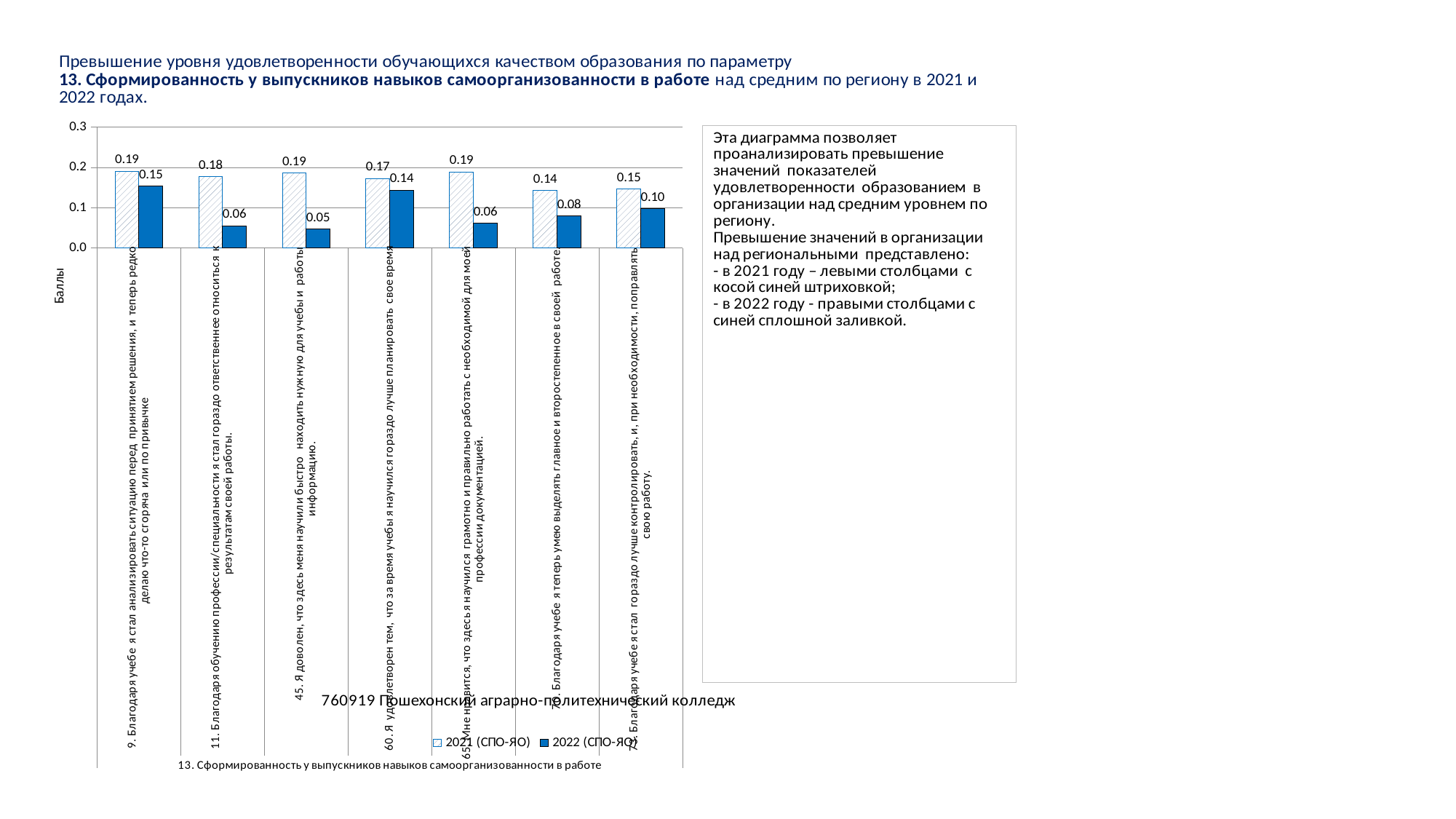
How many categories (statements) are plotted on the x axis? 7 What is the 2022 (СПО-ЯО) value for the last statement on the x axis ("Благодаря учебе я стал гораздо лучше контролировать и, при необходимости, поправлять свою работу")? 0.10 Which statement has the lowest 2022 (СПО-ЯО) value? 45. Я доволен, что здесь меня научили быстро находить нужную для учебы и работы информацию What type of chart is shown on the slide? bar chart What is the 2022 (СПО-ЯО) value for statement 45 ("Я доволен, что здесь меня научили быстро находить нужную для учебы и работы информацию")? 0.05 What is the 2022 (СПО-ЯО) value for statement 60 ("Я удовлетворен тем, что за время учебы я научился гораздо лучше планировать свое время")? 0.14 For statement 65 ("Мне нравится, что здесь я научился грамотно и правильно работать с необходимой для моей профессии документацией"), which series has the larger value, 2021 or 2022? 2021 (СПО-ЯО) What is the label of the vertical axis? Баллы Which statement has the highest 2022 (СПО-ЯО) value? 9. Благодаря учебе я стал анализировать ситуацию перед принятием решения, и теперь редко делаю что-то сгоряча или по привычке What is the 2021 (СПО-ЯО) value for statement 9 ("Благодаря учебе я стал анализировать ситуацию перед принятием решения...")? 0.19 How many series does the legend list? 2 What is the difference between the 2021 and 2022 values for statement 11 ("Благодаря обучению профессии/специальности я стал гораздо ответственнее относиться к результатам своей работы")? 0.12